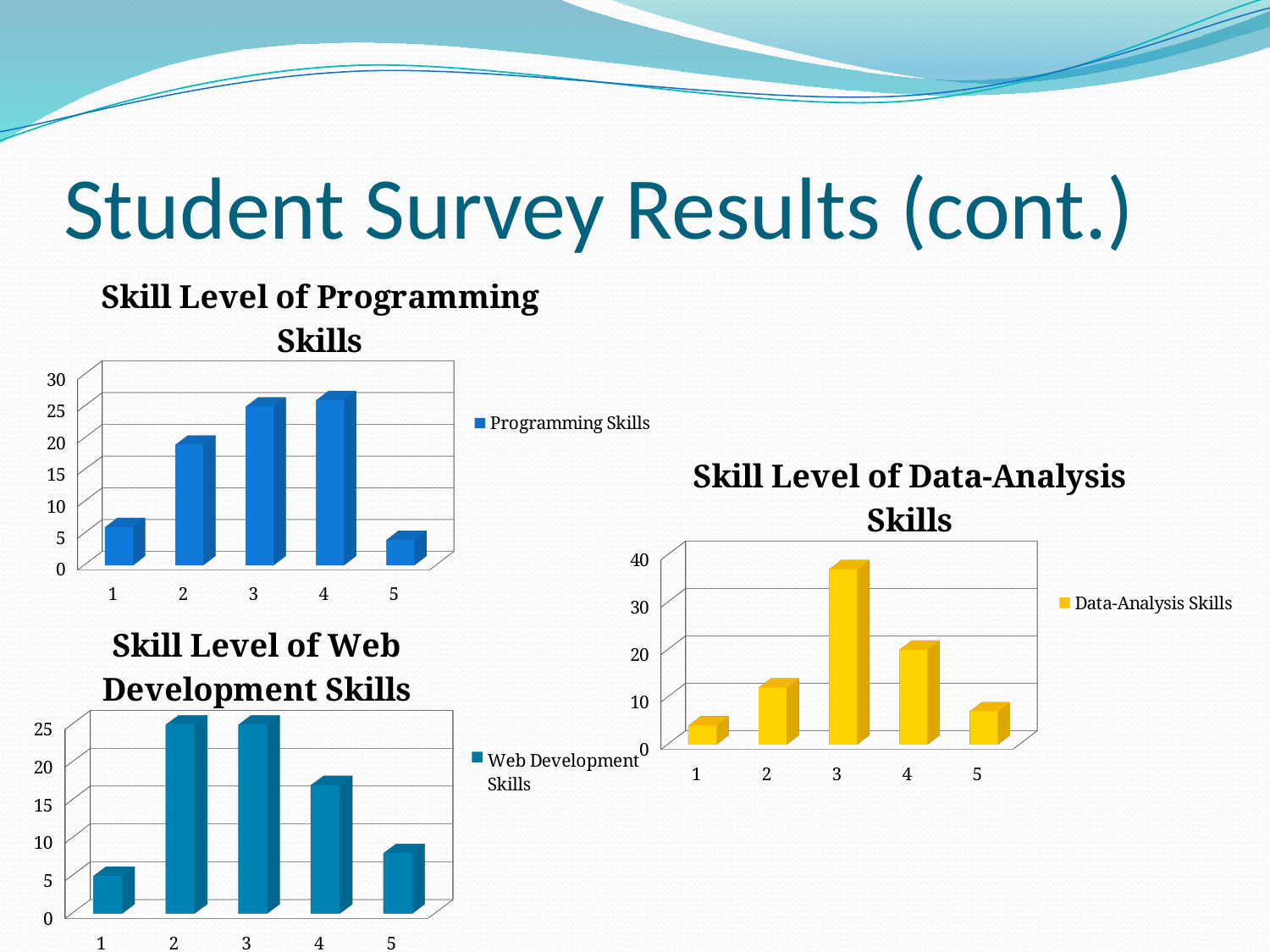
How many categories are shown on the x axis of the Skill Level of Web Development Skills chart? 5 In the Skill Level of Web Development Skills chart, which is larger, the value for category 4 or category 5? 4 In the Skill Level of Web Development Skills chart, is the value for category 5 greater or less than 10? less In the Skill Level of Programming Skills chart, is the value for category 2 greater or less than 15? greater How many series does the legend of the Skill Level of Data-Analysis Skills chart list? 1 In the Skill Level of Data-Analysis Skills chart, is the value for category 4 greater or less than 10? greater What kind of chart is the Skill Level of Programming Skills chart? bar chart In the Skill Level of Programming Skills chart, which is larger, the value for category 3 or category 1? 3 In the Skill Level of Data-Analysis Skills chart, which is larger, the value for category 2 or category 4? 4 In the Skill Level of Data-Analysis Skills chart, which category has the highest value? 3